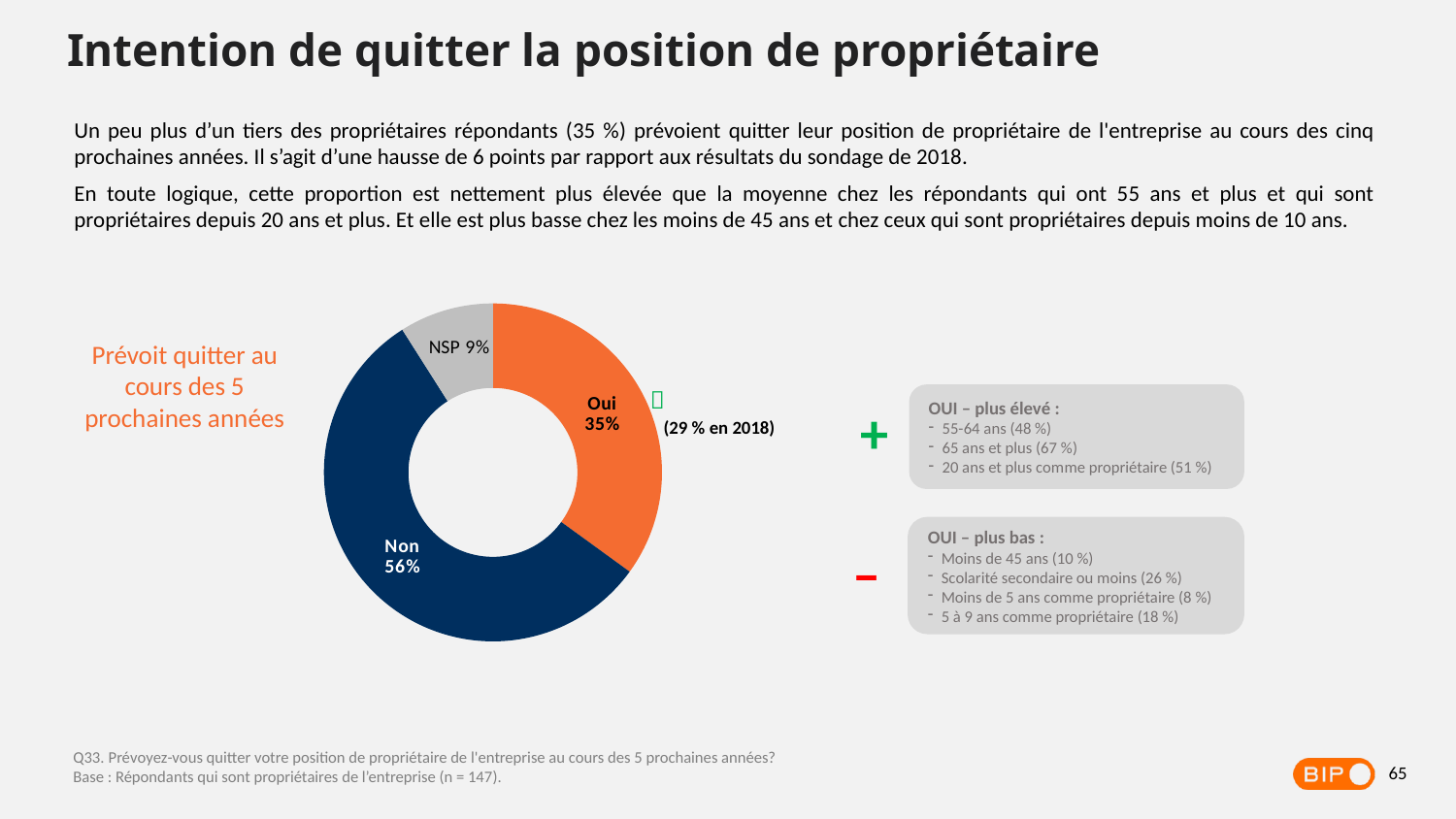
What percentage of respondents answered "Oui" in the donut chart? 35% Which is larger in the donut chart, the "Oui" share or the "NSP" share? Oui Which category has the smallest share in the donut chart? NSP How many categories are shown in the donut chart? 3 What was the "Oui" percentage in 2018, as noted next to the chart? 29 % What is the difference in percentage points between the "Non" and "Oui" shares? 21 Which category has the largest share in the donut chart? Non What is the combined share of "Oui" and "Non" in the donut chart? 91% What percentage of respondents answered "NSP" in the donut chart? 9% What colour is the "Oui" segment of the donut chart? Orange What type of chart is shown on the slide? Donut (pie) chart What percentage of respondents answered "Non" in the donut chart? 56%